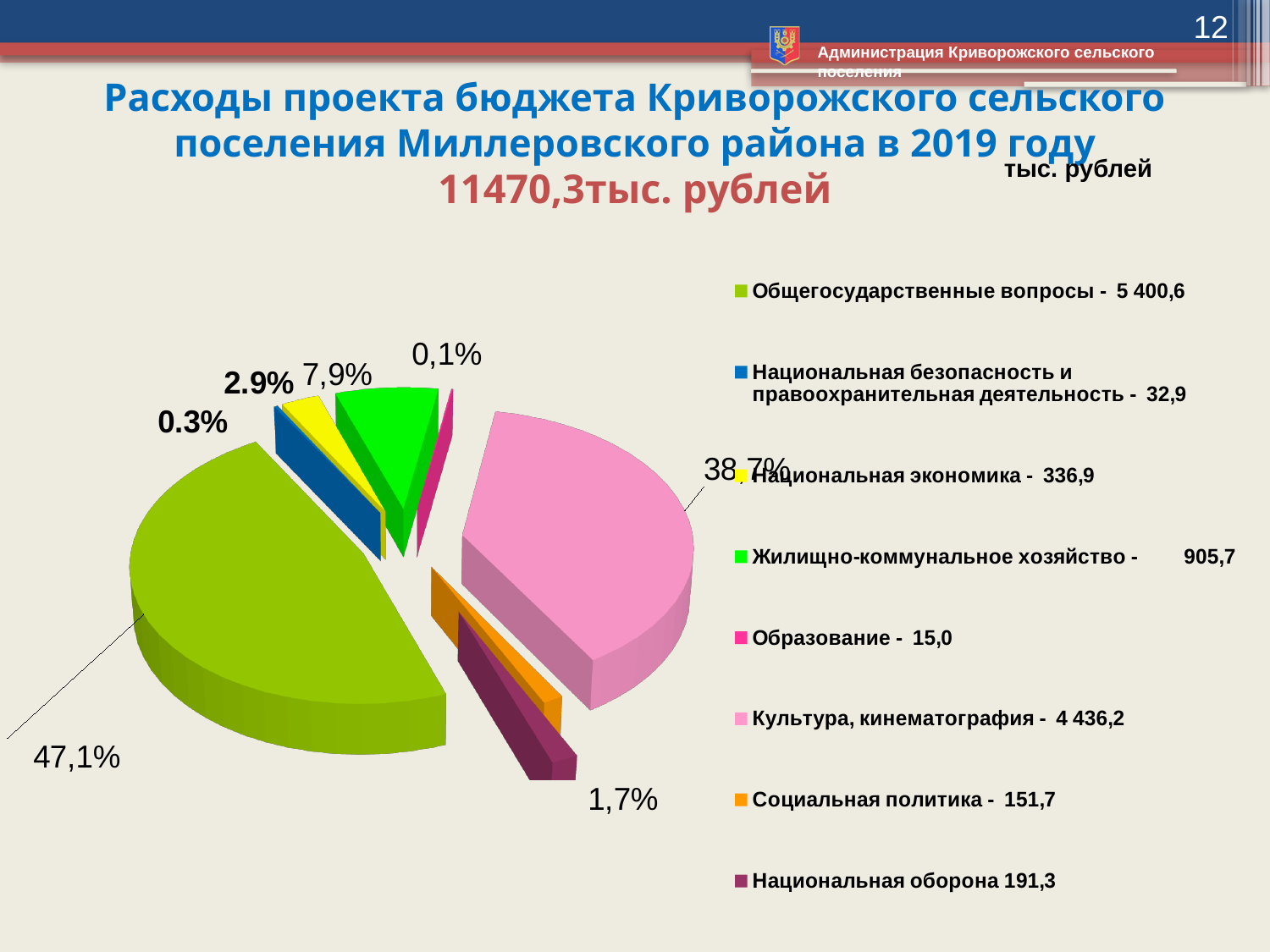
What is the difference between the values for Общегосударственные вопросы and Культура, кинематография? 964,4 What value does the legend give for Национальная оборона? 191,3 What value does the legend give for Культура, кинематография? 4 436,2 Which is larger: the value for Социальная политика or the value for Национальная экономика? Национальная экономика Which category has the smallest value in the legend? Образование What value does the legend give for Жилищно-коммунальное хозяйство? 905,7 What share of the pie is labelled for the largest slice (Общегосударственные вопросы)? 47,1% What kind of chart is shown on the slide? pie chart What total amount in тыс. рублей is stated in the chart title? 11470,3 How many categories does the legend of the pie chart list? 8 Which category has the largest slice of the pie? Общегосударственные вопросы What value does the legend give for Общегосударственные вопросы? 5 400,6